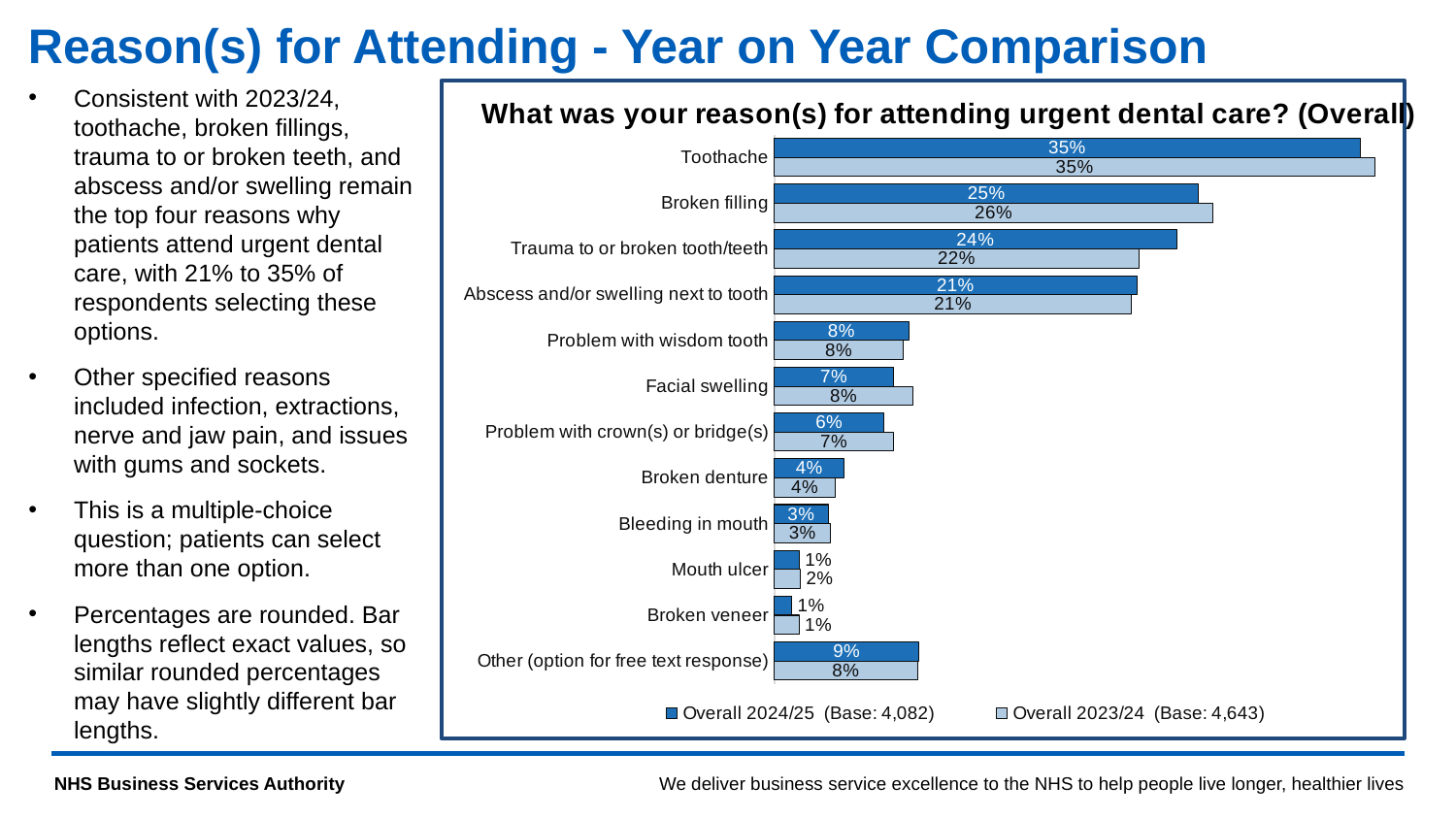
What was the Overall 2023/24 value for Broken filling? 26% What is the base (number of respondents) for the Overall 2024/25 series shown in the legend? 4,082 Which reason has the highest percentage in Overall 2024/25? Toothache What type of chart is shown on the slide? Bar chart How many reasons for attending are listed on the chart? 12 What is the difference in percentage points between Overall 2024/25 and Overall 2023/24 for Trauma to or broken tooth/teeth? 2 percentage points What was the Overall 2023/24 value for Mouth ulcer? 2% Which reason has the lowest percentage in Overall 2023/24? Broken veneer What percentage selected Other (option for free text response) in Overall 2024/25? 9% How many series does the legend list? 2 For Facial swelling, which series has the larger value: Overall 2024/25 or Overall 2023/24? Overall 2023/24 What percentage of respondents selected Toothache in Overall 2024/25? 35%